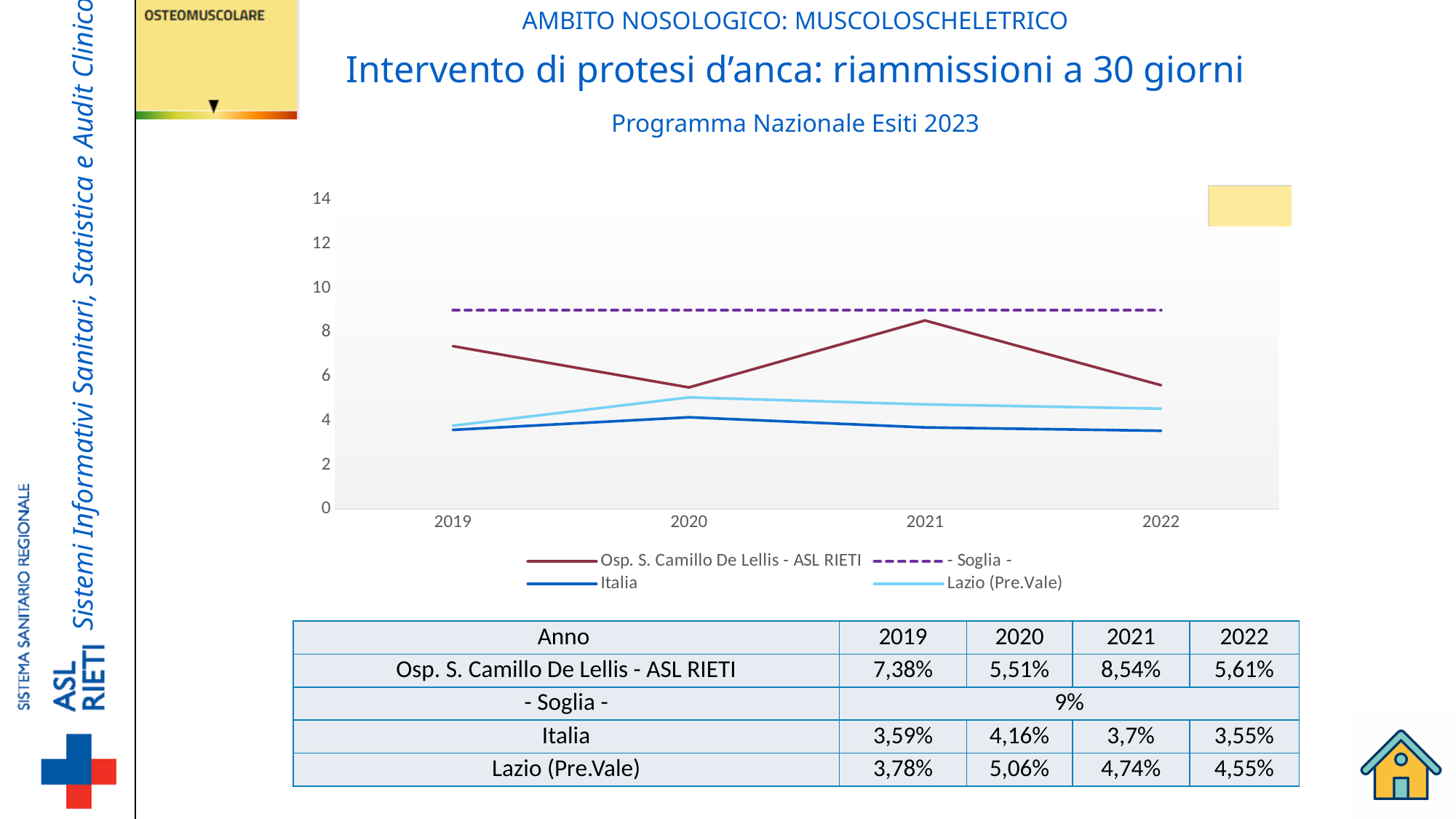
How many series does the chart legend list? 4 Is the value for Osp. S. Camillo De Lellis - ASL RIETI in 2021 greater or less than 8? greater What is the value of the Soglia (threshold) line? 9% What is the value for Italia in 2020? 4,16% What kind of chart is shown on the slide? line chart In which year is the value for Italia lowest? 2022 What is the value for Lazio (Pre.Vale) in 2022? 4,55% What is the value for Osp. S. Camillo De Lellis - ASL RIETI in 2021? 8,54% In which year is the value for Osp. S. Camillo De Lellis - ASL RIETI highest? 2021 What is the difference between the Osp. S. Camillo De Lellis - ASL RIETI values for 2021 and 2019? 1,16% How many years are plotted along the x axis of the chart? 4 In 2020, which is larger: the value for Lazio (Pre.Vale) or the value for Italia? Lazio (Pre.Vale)